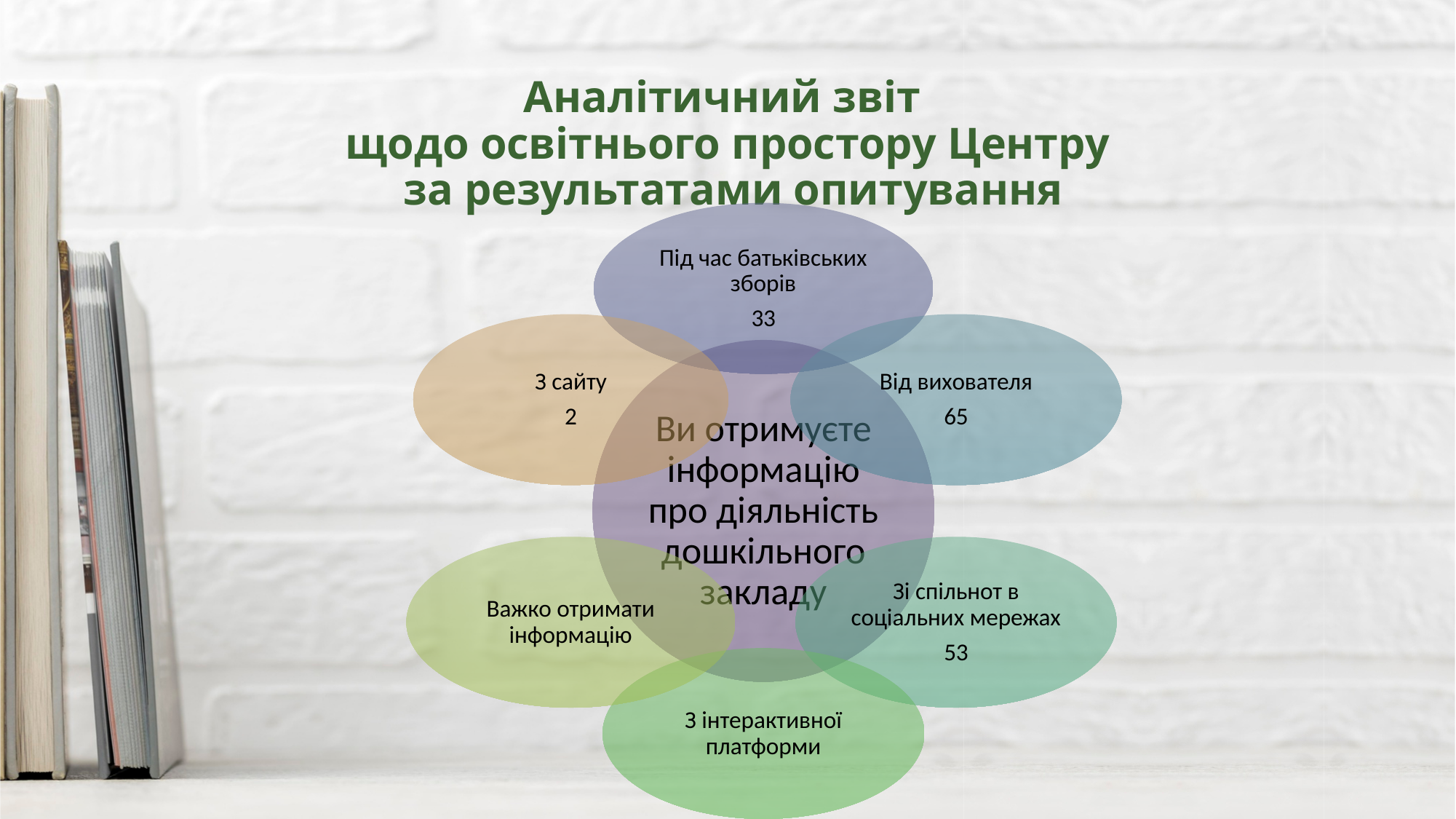
Which category has the highest value shown in the diagram? Від вихователя What is the difference between the values for "Зі спільнот в соціальних мережах" and "Під час батьківських зборів"? 20 What kind of diagram is shown on the slide? Venn diagram What value is shown for "З сайту"? 2 What value is shown for "Зі спільнот в соціальних мережах"? 53 What value is shown for "Під час батьківських зборів"? 33 How many categories (ellipses) are shown in the diagram? 6 Which category has the lowest value shown in the diagram? З сайту What value is shown for "Від вихователя"? 65 What is the difference between the values for "Від вихователя" and "Зі спільнот в соціальних мережах"? 12 What text is written in the centre of the diagram? Ви отримуєте інформацію про діяльність дошкільного закладу Which is larger: the value for "Під час батьківських зборів" or the value for "З сайту"? Під час батьківських зборів